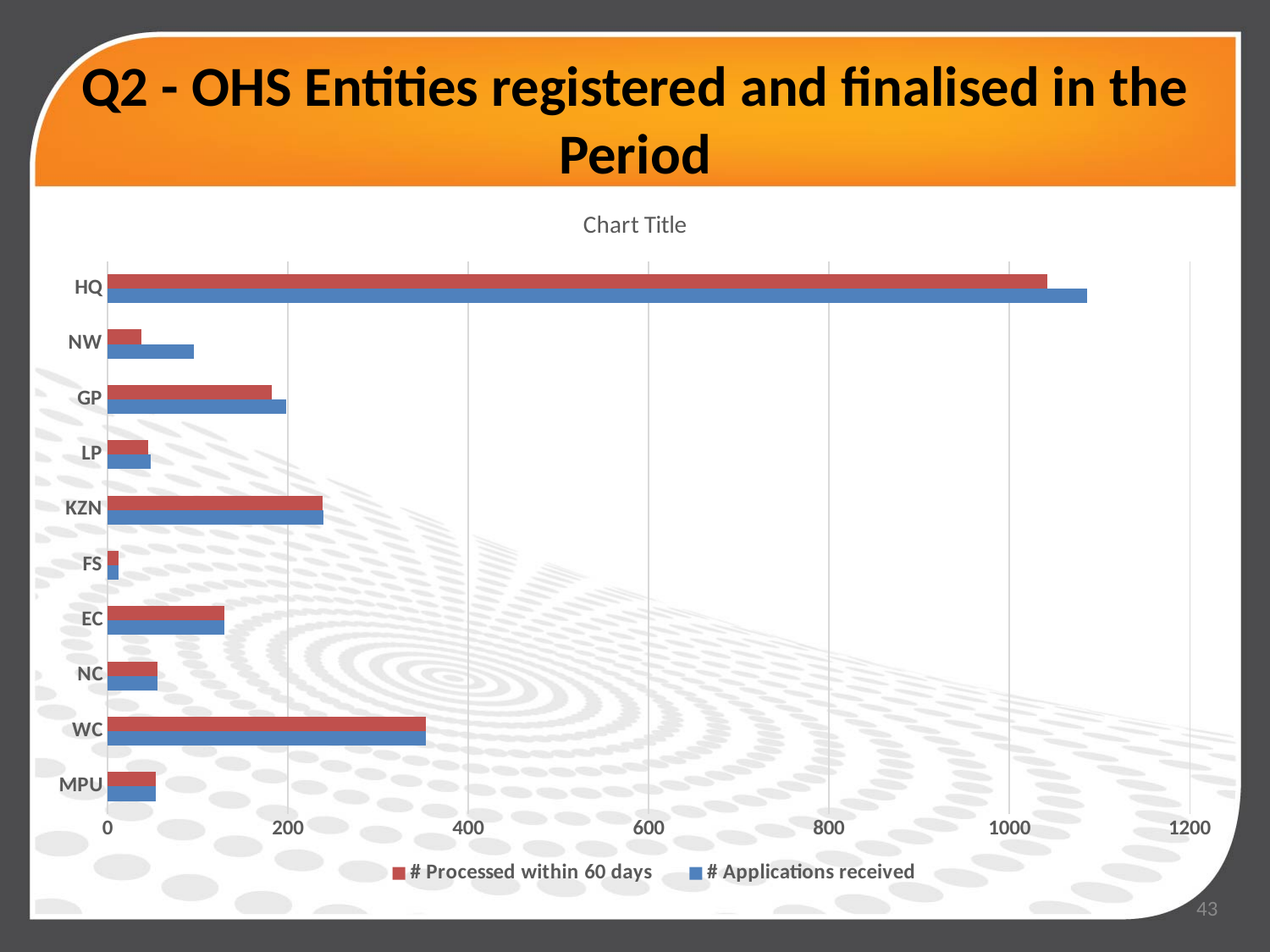
Is the value for # Applications received for NW greater or less than 200? less Which category has the highest value for # Applications received? HQ Is the value for # Processed within 60 days for WC greater or less than 400? less Is the value for # Applications received for KZN greater or less than 200? greater How many categories are shown on the vertical axis? 10 Which colour represents the # Processed within 60 days series? red Which category has the lowest value for # Processed within 60 days? FS How many series does the legend list? 2 For NW, which is larger: # Applications received or # Processed within 60 days? # Applications received What kind of chart is shown on the slide? bar chart Which has the larger value for # Applications received, WC or KZN? WC